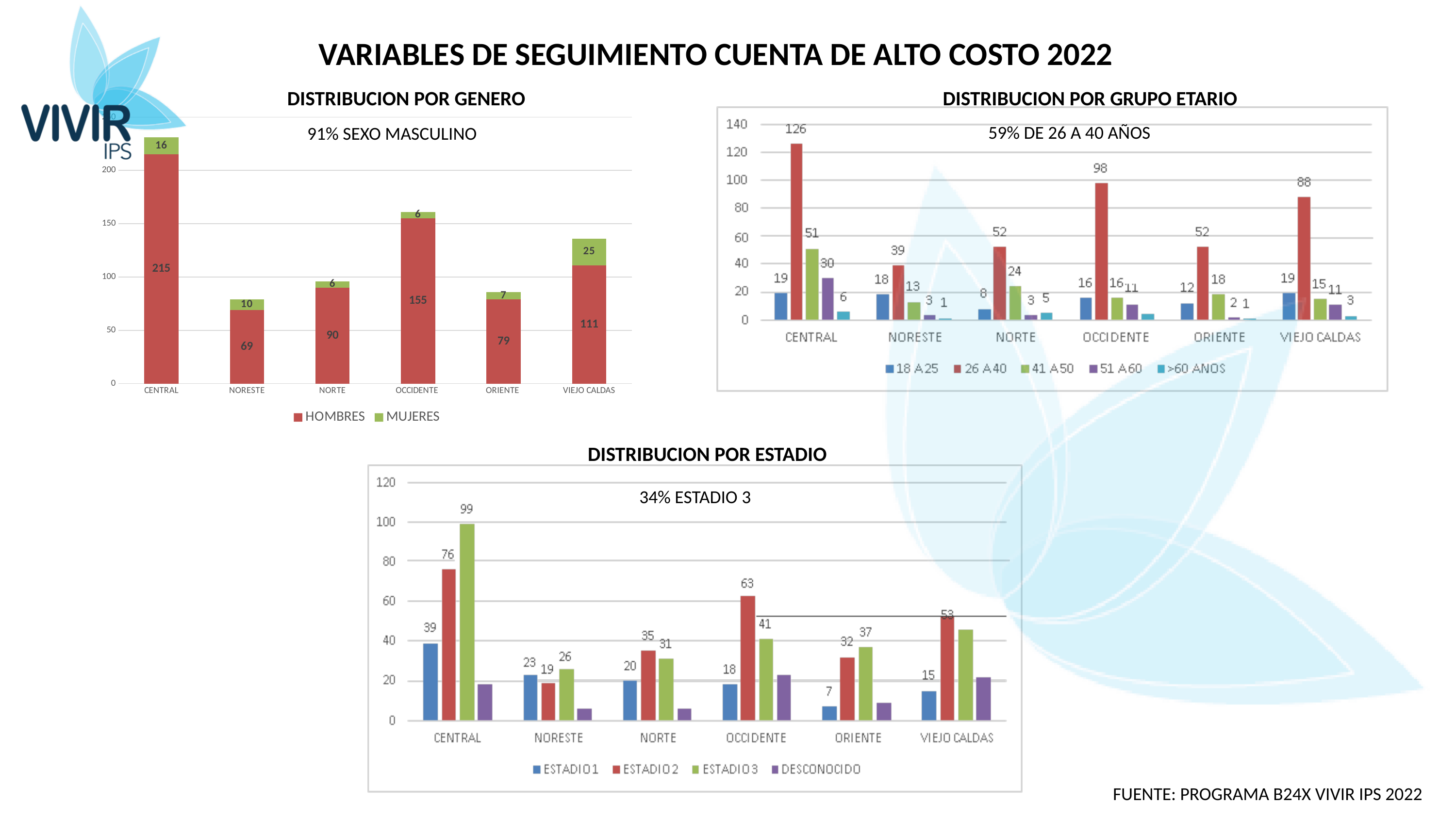
In the DISTRIBUCION POR ESTADIO chart, how many categories are shown on the x axis? 6 In the DISTRIBUCION POR GRUPO ETARIO chart, is the 41 A 50 value for CENTRAL greater or less than 40? greater In the DISTRIBUCION POR GENERO chart, how many series does the legend list? 2 In the DISTRIBUCION POR ESTADIO chart, what is the ESTADIO 3 value for CENTRAL? 99 In the DISTRIBUCION POR GRUPO ETARIO chart, which category has the highest 26 A 40 value? CENTRAL In the DISTRIBUCION POR GRUPO ETARIO chart, how many series does the legend list? 5 In the DISTRIBUCION POR GENERO chart, what is the difference between the HOMBRES values for OCCIDENTE and NORTE? 65 In the DISTRIBUCION POR GENERO chart, what is the HOMBRES value for CENTRAL? 215 In the DISTRIBUCION POR GRUPO ETARIO chart, what is the 26 A 40 value for OCCIDENTE? 98 In the DISTRIBUCION POR GENERO chart, which category has the lowest HOMBRES value? NORESTE In the DISTRIBUCION POR ESTADIO chart, which is larger for ORIENTE: ESTADIO 2 or ESTADIO 3? ESTADIO 3 In the DISTRIBUCION POR GENERO chart, what is the total of the stacked bar for VIEJO CALDAS? 136